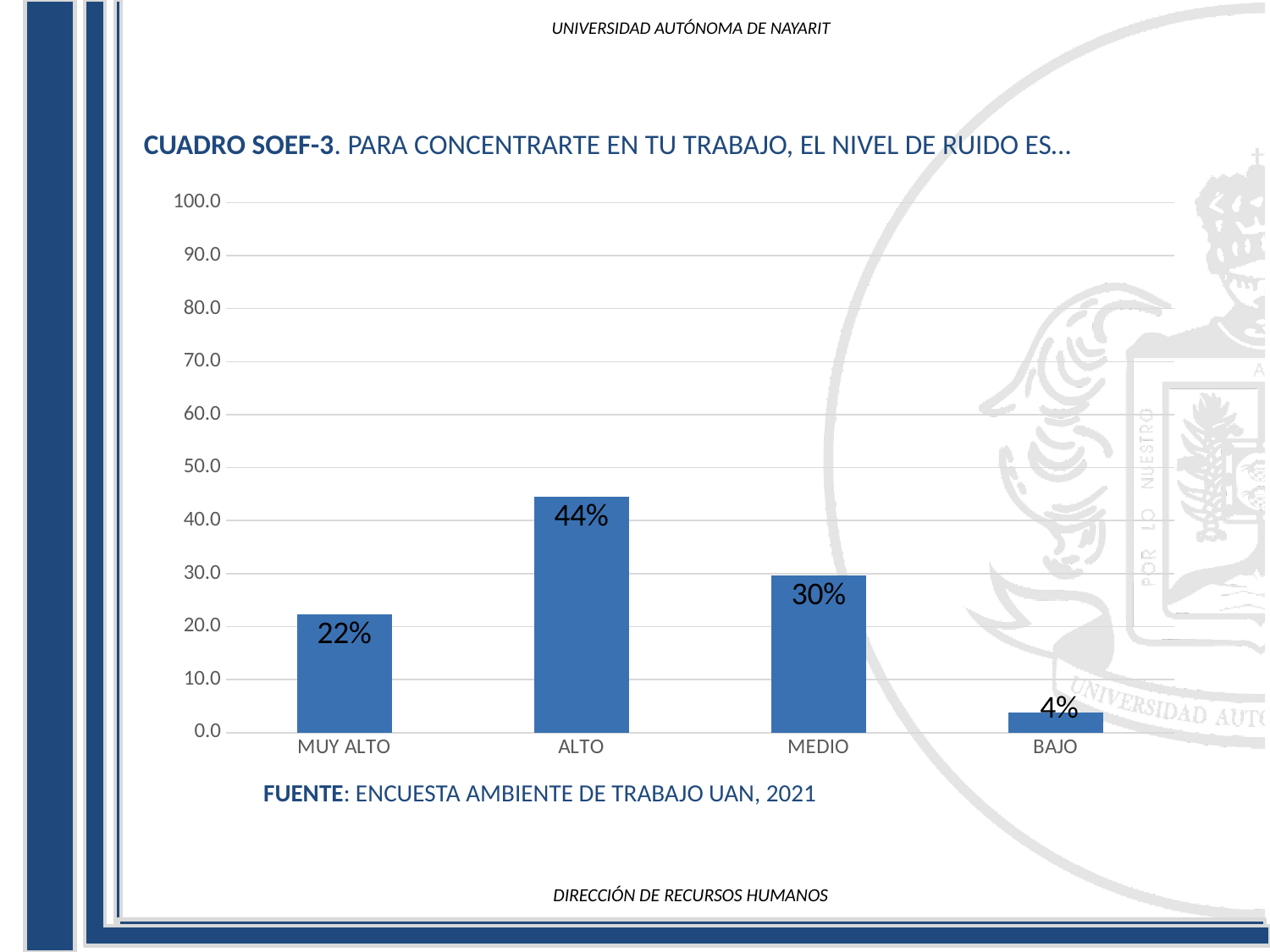
What is the value for BAJO? 4% What kind of chart is shown on the slide? bar chart What is the value for ALTO? 44% What is the value for MUY ALTO? 22% What source is cited below the chart? ENCUESTA AMBIENTE DE TRABAJO UAN, 2021 Is the value for ALTO greater or less than 50.0? less Which category has the lowest value? BAJO What is the value for MEDIO? 30% Which is larger, the value for MUY ALTO or the value for MEDIO? MEDIO What is the difference between the values for ALTO and MEDIO? 14% How many categories are shown on the x axis? 4 Which category has the highest value? ALTO